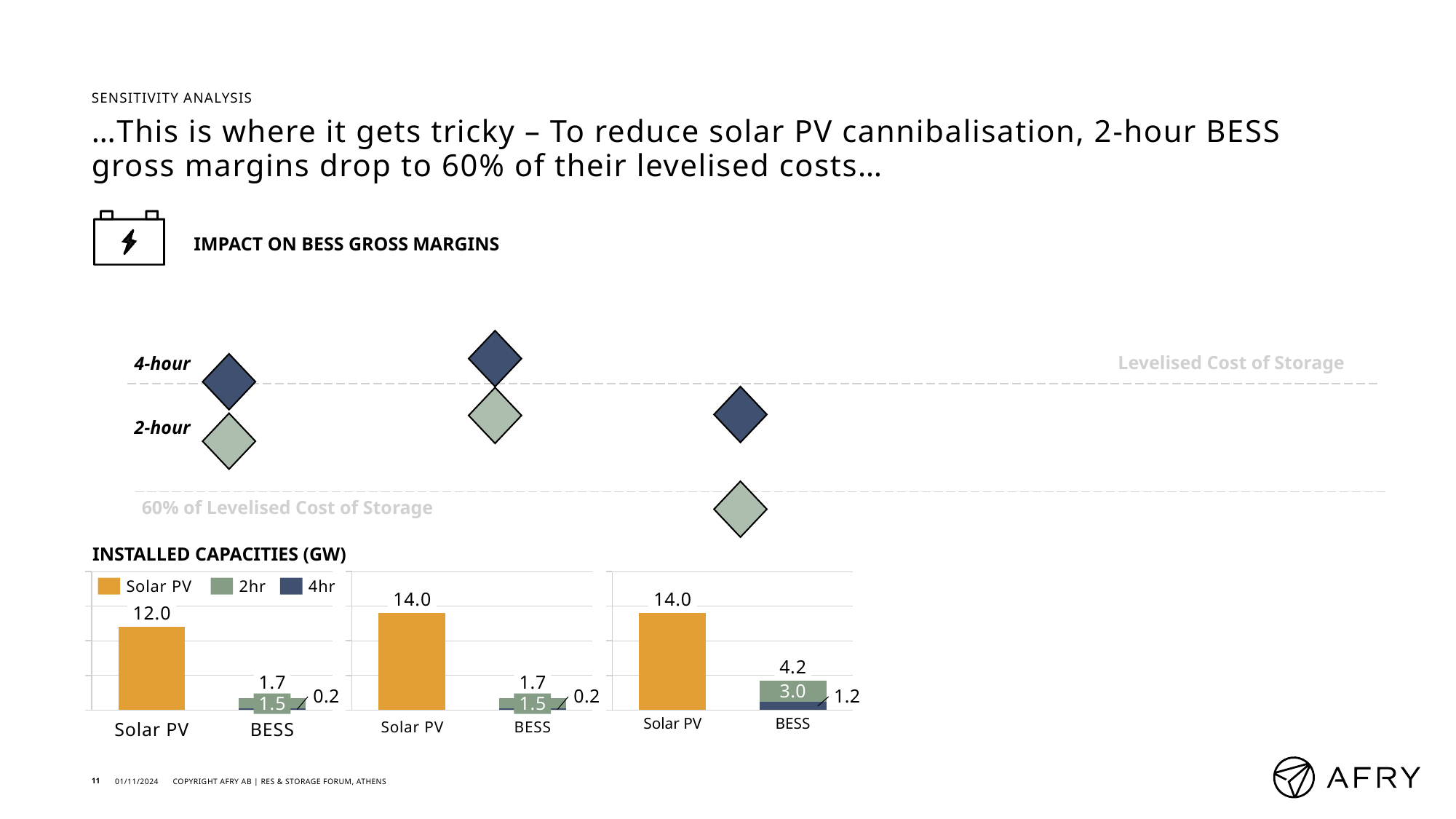
In the rightmost installed capacities chart, what is the difference between the Solar PV value and the BESS total? 9.8 In the rightmost installed capacities chart, what is the value of the 2hr segment of the BESS bar? 3.0 What kind of chart are the installed capacities charts? bar chart In the rightmost installed capacities chart, what is the total of the stacked BESS bar? 4.2 Which has a larger Solar PV value: the leftmost installed capacities chart or the middle one? the middle chart In the leftmost installed capacities chart, what is the difference between the Solar PV value and the BESS total? 10.3 In the leftmost installed capacities chart, what is the value for Solar PV? 12.0 In the rightmost installed capacities chart, how much larger is the 2hr segment than the 4hr segment of the BESS bar? 1.8 How many series does the legend of the installed capacities charts list? 3 In the installed capacities legend, what colour represents Solar PV? orange In the rightmost installed capacities chart, what is the value of the 4hr segment of the BESS bar? 1.2 In the middle installed capacities chart, what is the value of the 4hr segment of the BESS bar? 0.2